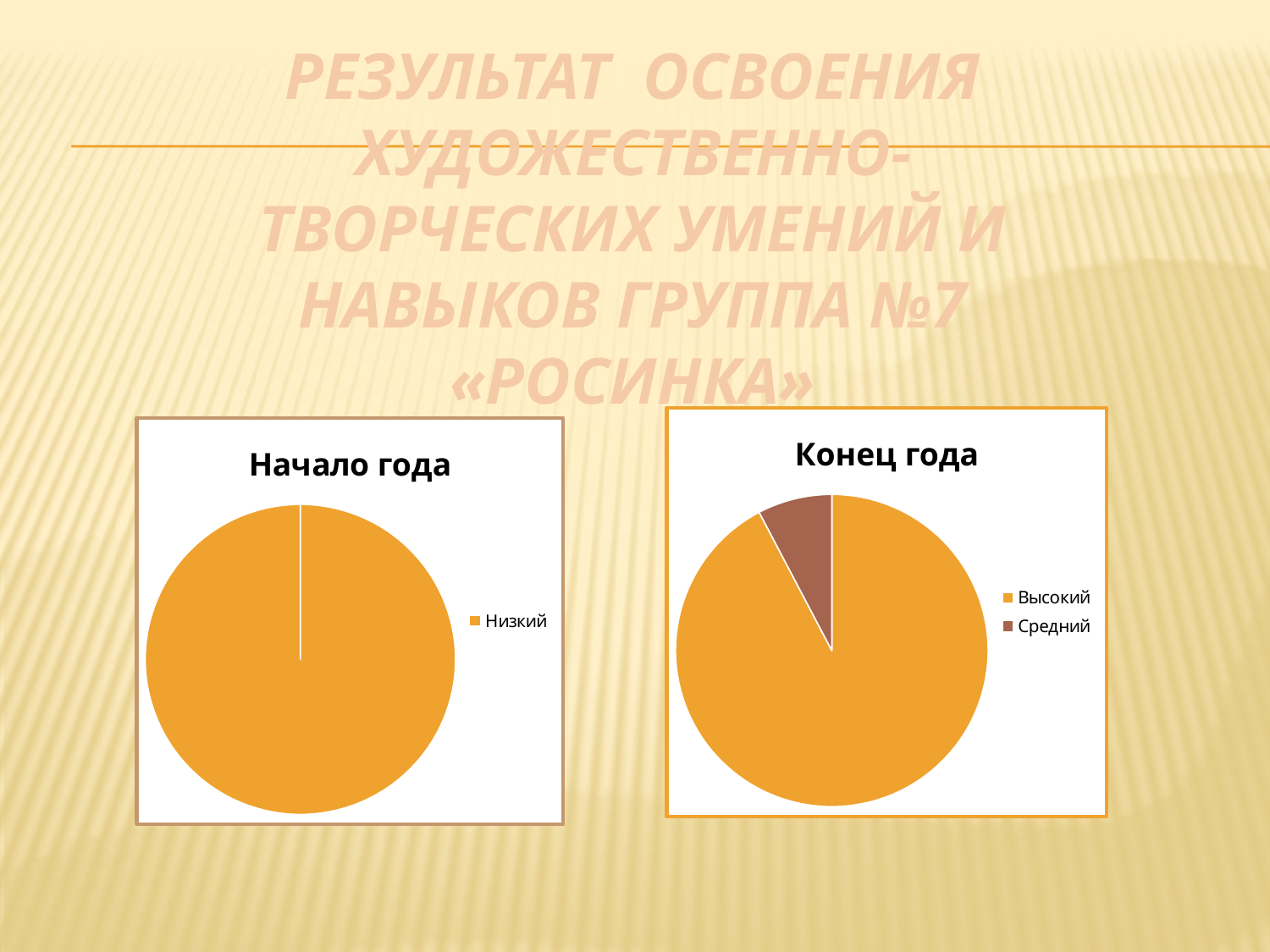
How many slices does the "Начало года" pie chart have? 1 What kind of chart is the "Начало года" chart? pie chart What is the only category shown in the "Начало года" pie chart? Низкий What kind of chart is the "Конец года" chart? pie chart What is the title of the pie chart on the right side of the slide? Конец года How many entries does the legend of the "Начало года" chart list? 1 In the "Конец года" chart, which category has the smallest slice? Средний In the "Конец года" chart, which category has the largest slice? Высокий In the "Конец года" chart, which slice is larger, Высокий or Средний? Высокий How many entries does the legend of the "Конец года" chart list? 2 How many slices does the "Конец года" pie chart have? 2